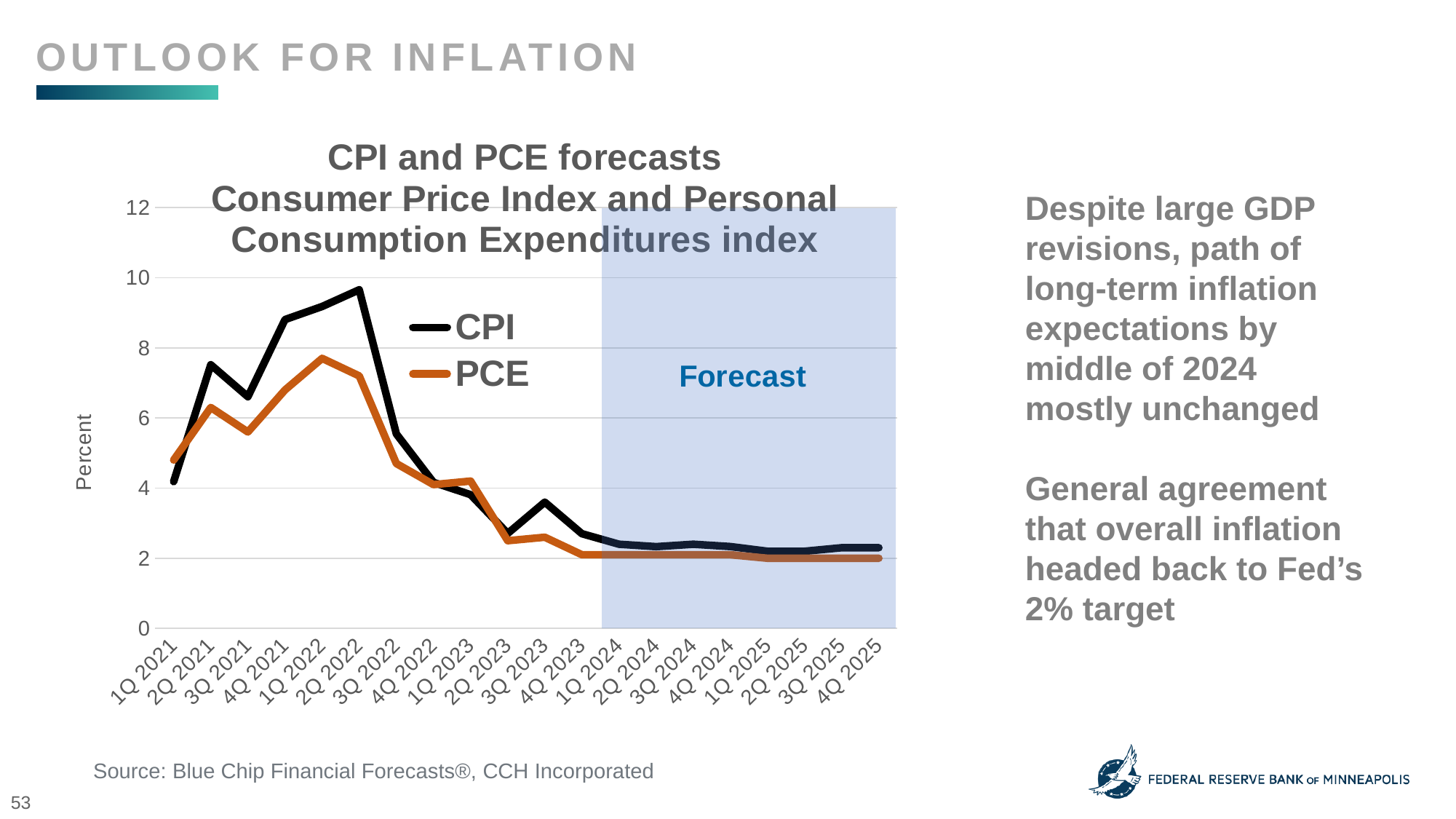
In which quarter does the CPI line reach its highest value? 2Q 2022 Is the CPI value for 4Q 2023 greater or less than 4? less Is the PCE value for 4Q 2025 greater or less than 4? less Does the CPI line rise or fall from 2Q 2022 to 4Q 2023? Fall How many quarters are plotted along the x axis? 20 What kind of chart is shown on the slide? Line chart In which quarter does the PCE line reach its highest value? 1Q 2022 At 2Q 2022, which series is higher, CPI or PCE? CPI Is the CPI value for 2Q 2022 greater or less than 8? greater What label is shown on the shaded region covering 1Q 2024 to 4Q 2025? Forecast How many series does the legend list? 2